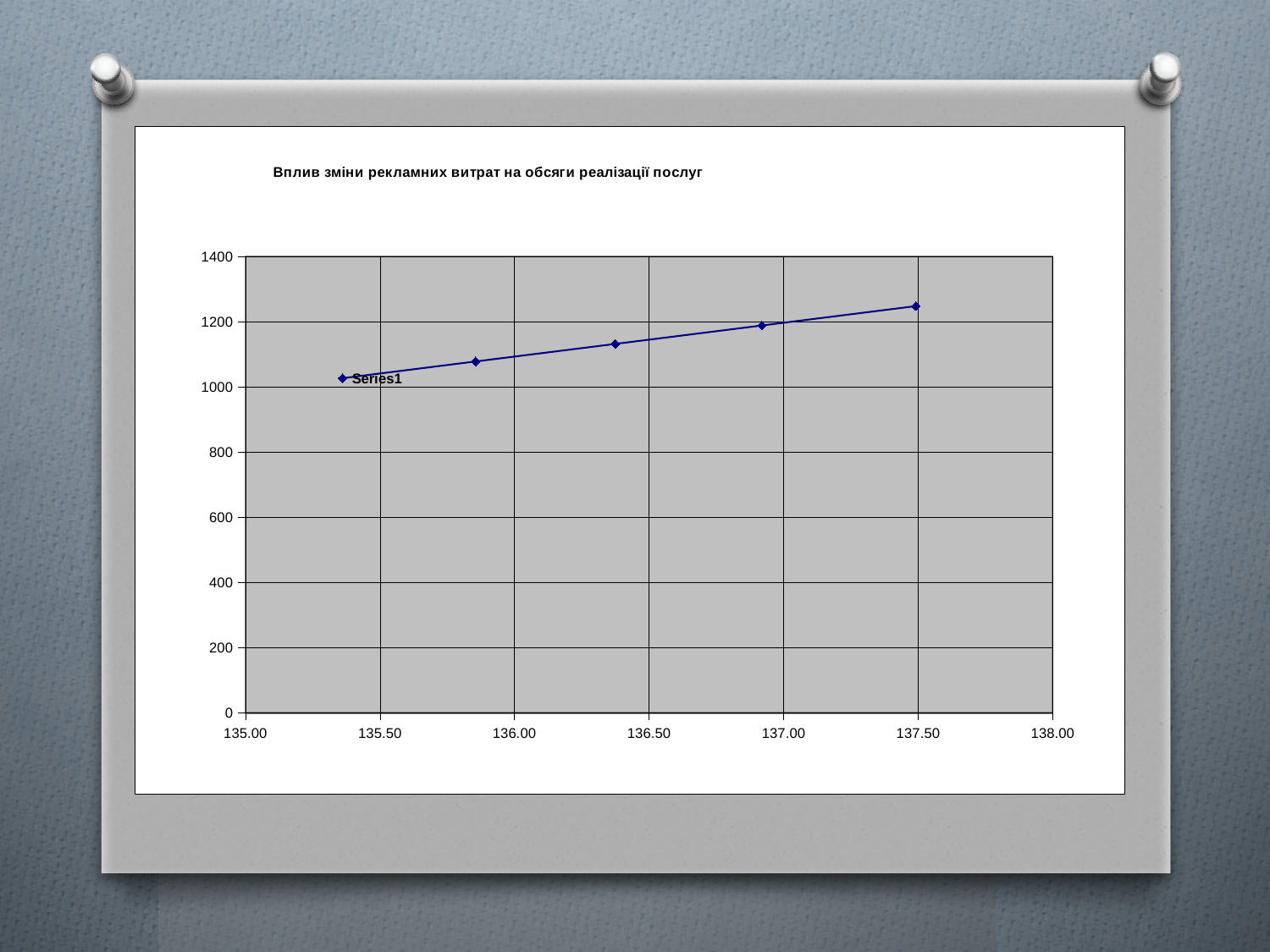
What is the name of the series labelled on the chart? Series1 Is the value of the second data point from the left greater or less than 1200? less Is the lowest data point at the left end or the right end of the line? left end What is the title of the chart? Вплив зміни рекламних витрат на обсяги реалізації послуг What kind of chart is shown on the slide? line chart Is the value of the rightmost data point greater or less than 1200? greater Is the value of the middle (third) data point greater or less than 1000? greater Do the values rise or fall as you move from left to right along the x axis? rise How many series does the chart show? 1 Is the highest data point at the left end or the right end of the line? right end How many data points are plotted on the line? 5